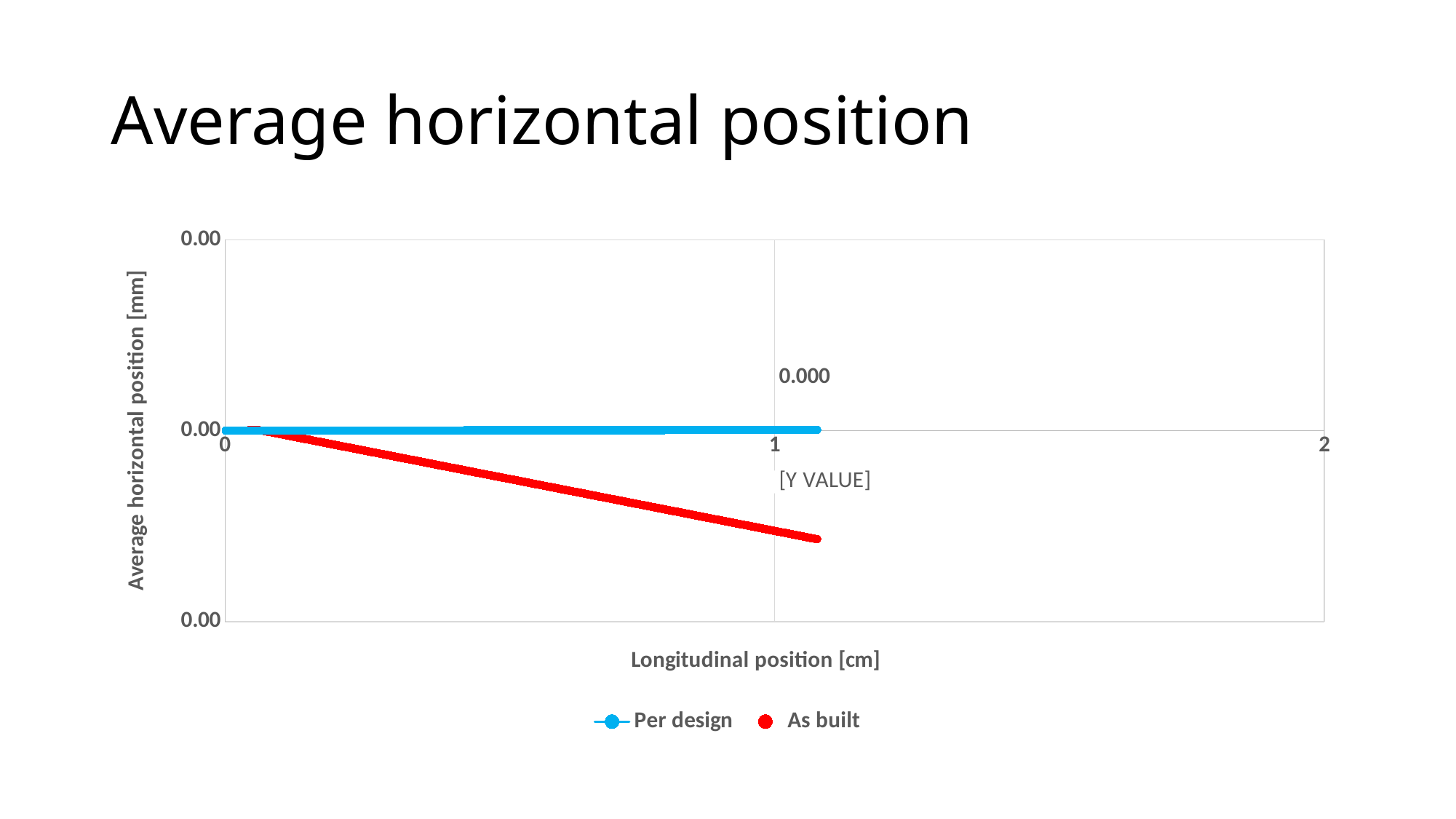
Which series is drawn in red? As built What is the x-axis title of the chart? Longitudinal position [cm] What is the highest value shown on the x axis? 2 What kind of chart is shown on the slide? line chart What is the title of the chart? Average horizontal position What are the two series named in the legend? Per design, As built What is the y-axis title of the chart? Average horizontal position [mm] What value is printed as the data label on the Per design series? 0.000 Does the As built series rise or fall as the longitudinal position increases? fall Does the Per design series rise, fall, or stay flat as the longitudinal position increases? stay flat At a longitudinal position of 1 cm, which series has the higher value, Per design or As built? Per design How many series does the legend list? 2